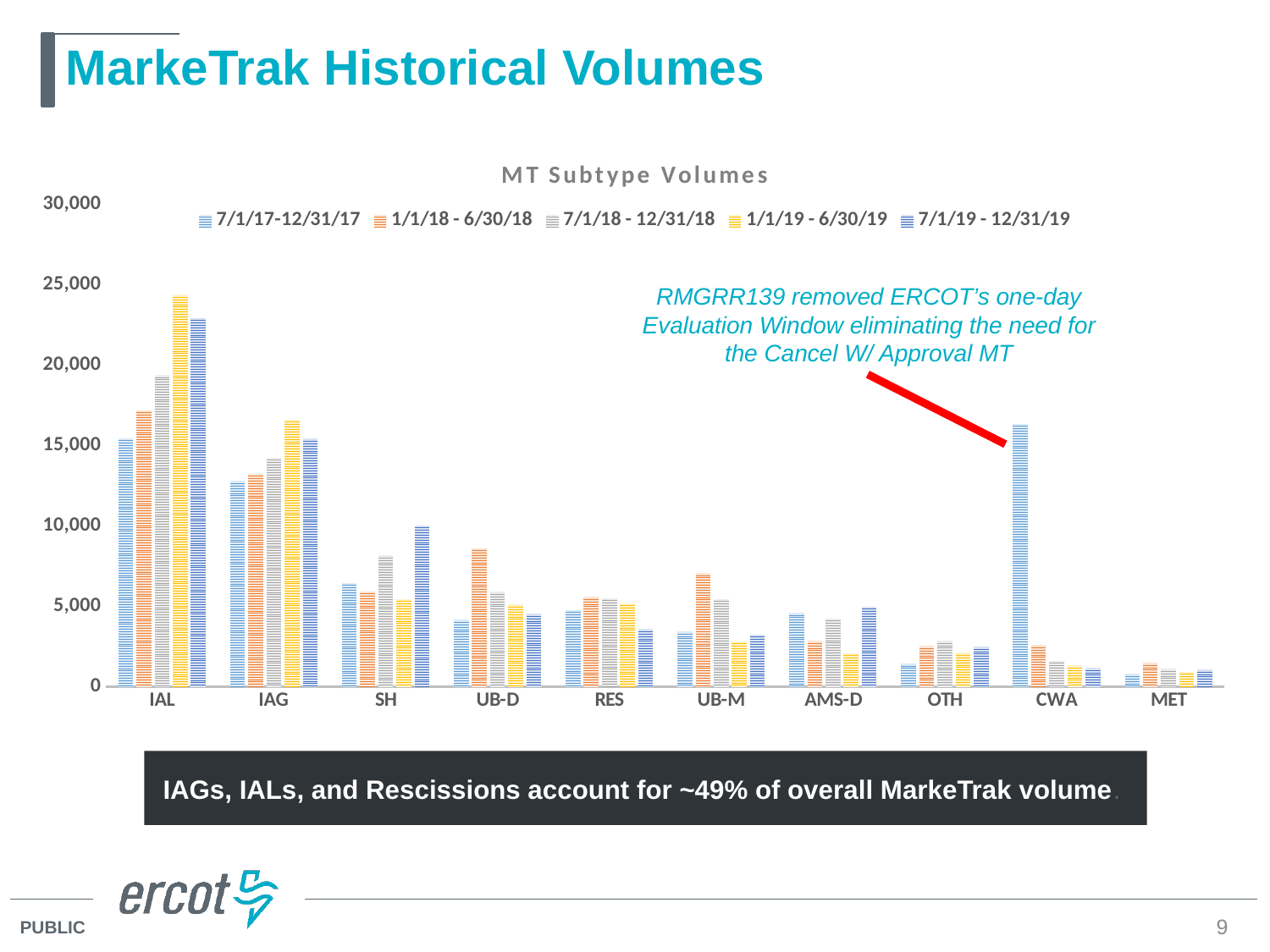
What kind of chart is shown on the slide? Bar chart How many MT subtype categories are shown along the x axis? 10 For the CWA category, do the values rise or fall across the five periods from left to right? fall How many series does the legend of the MT Subtype Volumes chart list? 5 For CWA, which period has the larger value, 7/1/17-12/31/17 or 1/1/18 - 6/30/18? 7/1/17-12/31/17 What is the title of the chart? MT Subtype Volumes Is the value for CWA in the 7/1/17-12/31/17 period greater or less than 15,000? greater Which category contains the tallest bar in the chart? IAL For the 7/1/17-12/31/17 period, which category has the larger value, IAL or IAG? IAL Is the value for IAL in the 1/1/19 - 6/30/19 period greater or less than 20,000? greater Is the value for UB-M in the 1/1/18 - 6/30/18 period greater or less than 5,000? greater Which category has the lowest bars overall in the chart? MET